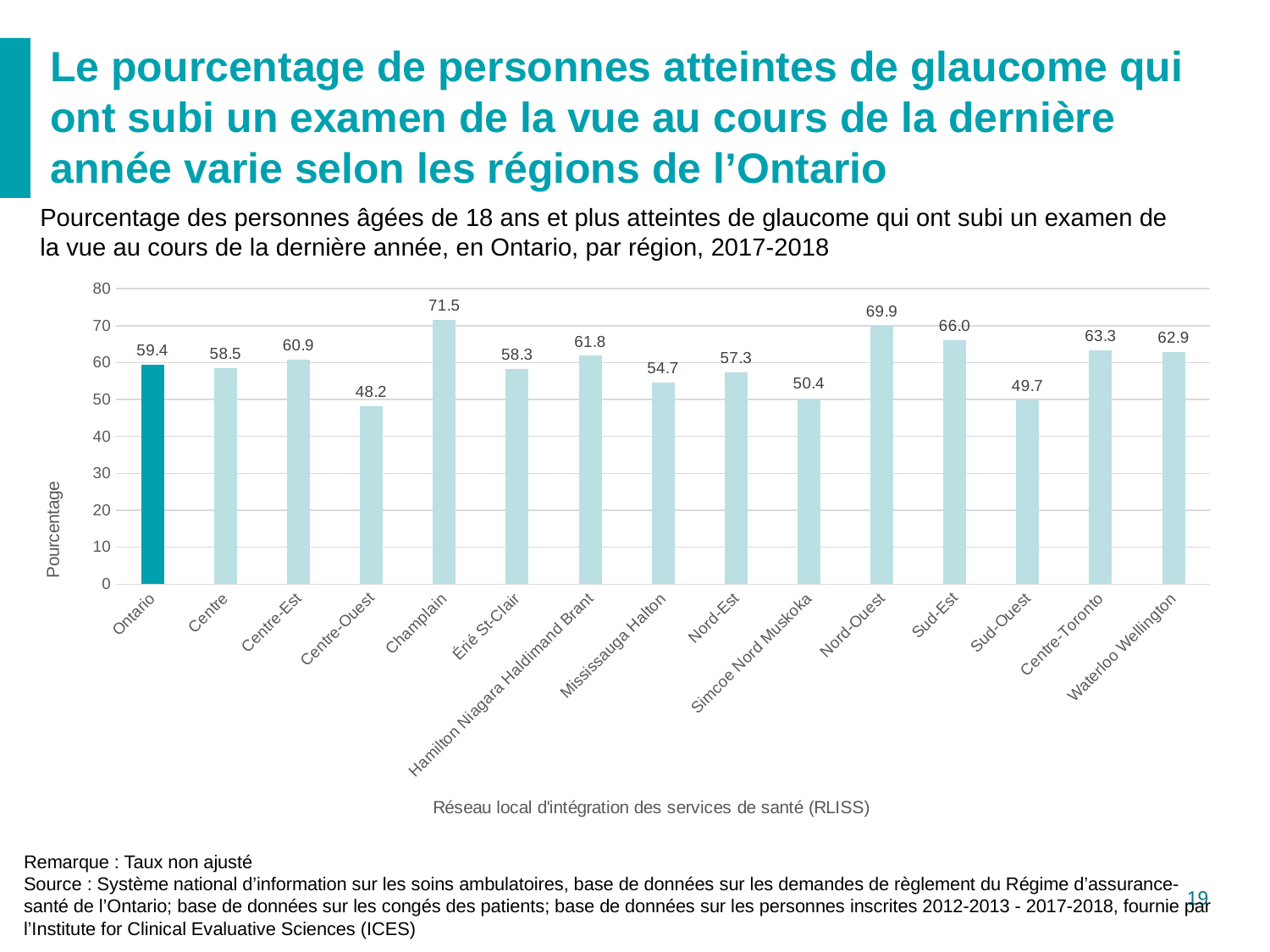
What is the value for Simcoe Nord Muskoka? 50.4 How many categories are shown on the x axis? 15 What kind of chart is shown on the slide? bar chart Which bar is shown in a darker colour than the others? Ontario What is the value for Champlain? 71.5 Which region has the highest percentage? Champlain What is the difference between the values for Champlain and Centre-Ouest? 23.3 What is the label of the y axis? Pourcentage Is the value for Sud-Ouest greater or less than 50? less What is the value for Ontario? 59.4 Which region has the lowest percentage? Centre-Ouest Which is larger, the value for Nord-Ouest or the value for Sud-Est? Nord-Ouest